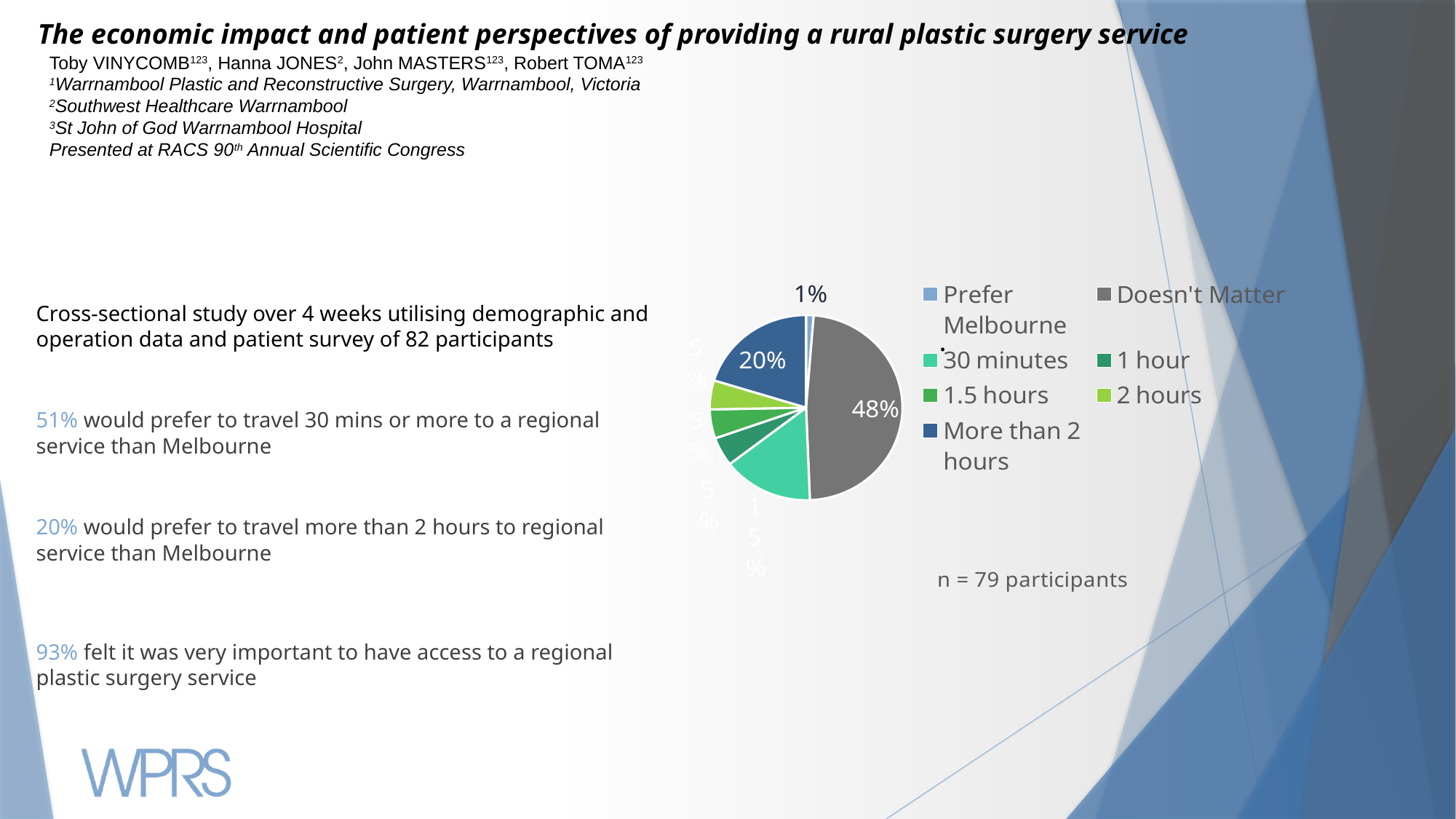
What percentage of the pie chart is the 'Doesn't Matter' slice? 48% What percentage of the pie chart is the 'Prefer Melbourne' slice? 1% How many categories does the pie chart's legend list? 7 Which category has the smallest slice of the pie chart? Prefer Melbourne What kind of chart is shown on the slide? pie chart How many participants does the note below the pie chart say the chart is based on? n = 79 participants Which category has the largest slice of the pie chart? Doesn't Matter What is the difference in percentage points between the 'More than 2 hours' slice and the 'Prefer Melbourne' slice? 19% Which slice is larger in the pie chart: 'Doesn't Matter' or 'More than 2 hours'? Doesn't Matter What is the difference in percentage points between the 'Doesn't Matter' slice and the 'More than 2 hours' slice? 28% Which slice is larger in the pie chart: '30 minutes' or 'Doesn't Matter'? Doesn't Matter What percentage of the pie chart is the 'More than 2 hours' slice? 20%